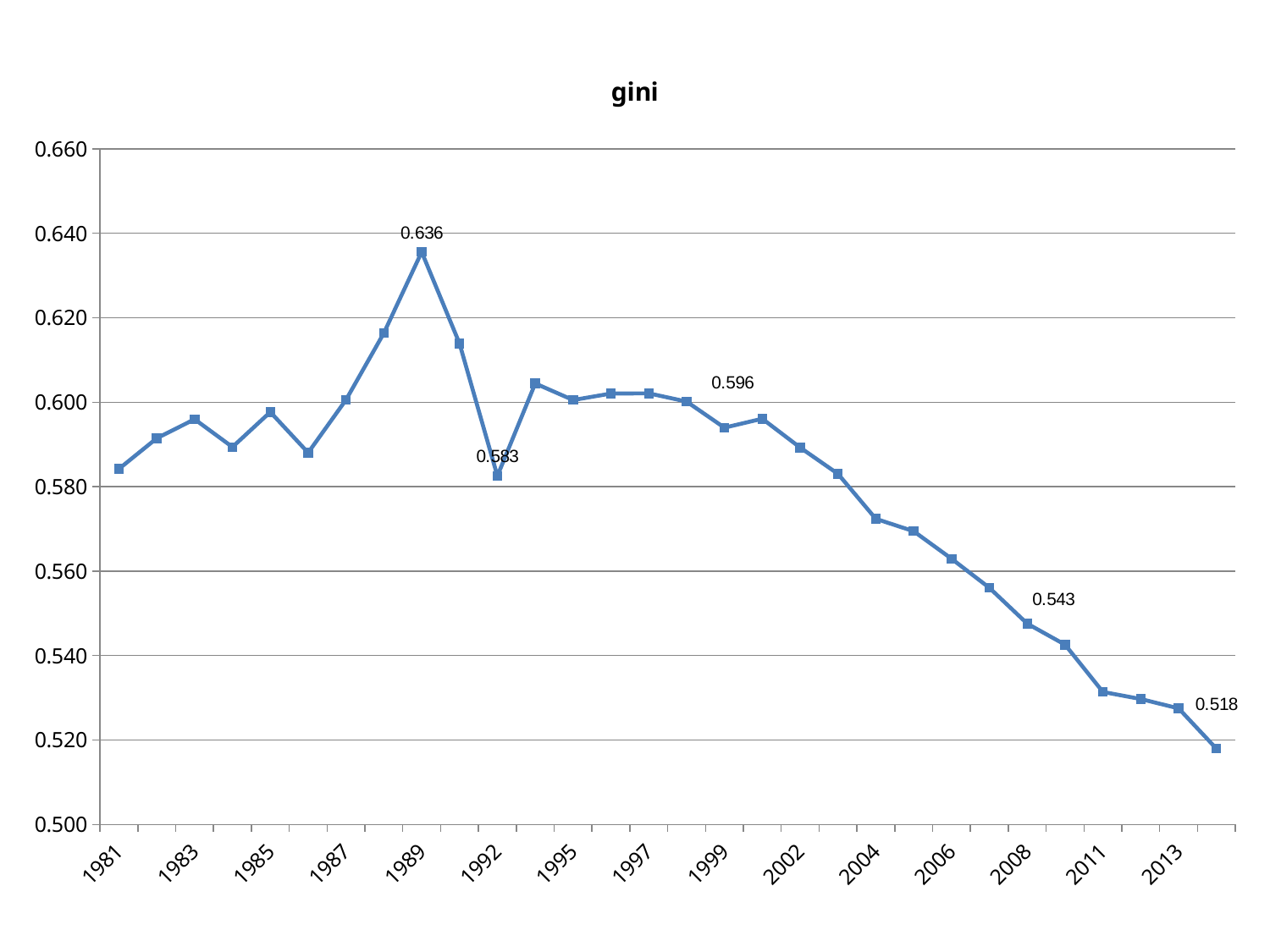
Does the gini line rise or fall from 1989 to 2013? fall Which year has the larger gini value, 1989 or 1992? 1989 What is the gini value for 1992? 0.583 What is the title of the chart? gini Is the gini value for 2008 greater or less than 0.560? less What kind of chart is shown on the slide? line chart Is the gini value for 1981 greater or less than 0.600? less What is the lowest gini value shown on the chart? 0.518 Is the gini value for 2013 greater or less than 0.540? less In which year does the gini line reach its highest value? 1989 What is the gini value for 1989? 0.636 What is the difference between the gini values for 1989 and 1992? 0.053